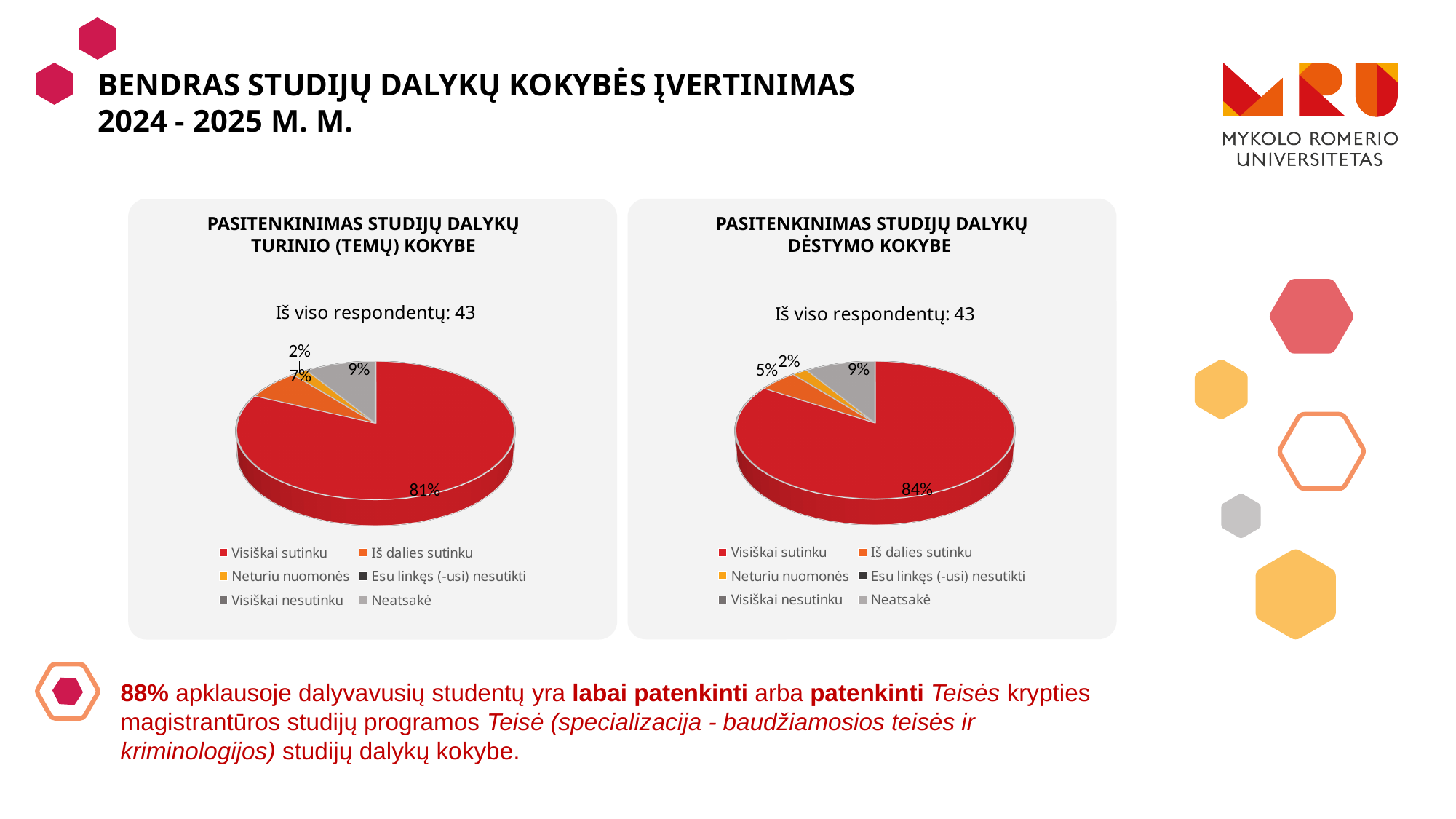
In the right chart (Pasitenkinimas studijų dalykų dėstymo kokybe), what share is shown for "Iš dalies sutinku"? 5% In the left chart (Pasitenkinimas studijų dalykų turinio (temų) kokybe), which category has the largest slice? Visiškai sutinku In the right chart (Pasitenkinimas studijų dalykų dėstymo kokybe), what share is shown for "Neatsakė"? 9% In the left chart (Pasitenkinimas studijų dalykų turinio (temų) kokybe), what share of respondents answered "Visiškai sutinku"? 81% In the right chart (Pasitenkinimas studijų dalykų dėstymo kokybe), what share of respondents answered "Visiškai sutinku"? 84% In the left chart (Pasitenkinimas studijų dalykų turinio (temų) kokybe), what share is shown for "Iš dalies sutinku"? 7% In the left chart (Pasitenkinimas studijų dalykų turinio (temų) kokybe), which labelled category has the smallest slice? Neturiu nuomonės How many entries does the legend of the left chart (Pasitenkinimas studijų dalykų turinio (temų) kokybe) list? 6 How many respondents in total are reported for the right chart (Pasitenkinimas studijų dalykų dėstymo kokybe)? 43 What is the difference between the "Visiškai sutinku" share in the right chart (dėstymo kokybe) and in the left chart (turinio kokybe)? 3% Which chart has the larger "Iš dalies sutinku" share: the left chart (turinio kokybe) or the right chart (dėstymo kokybe)? The left chart (turinio kokybe) What type of chart is used on this slide? Pie chart